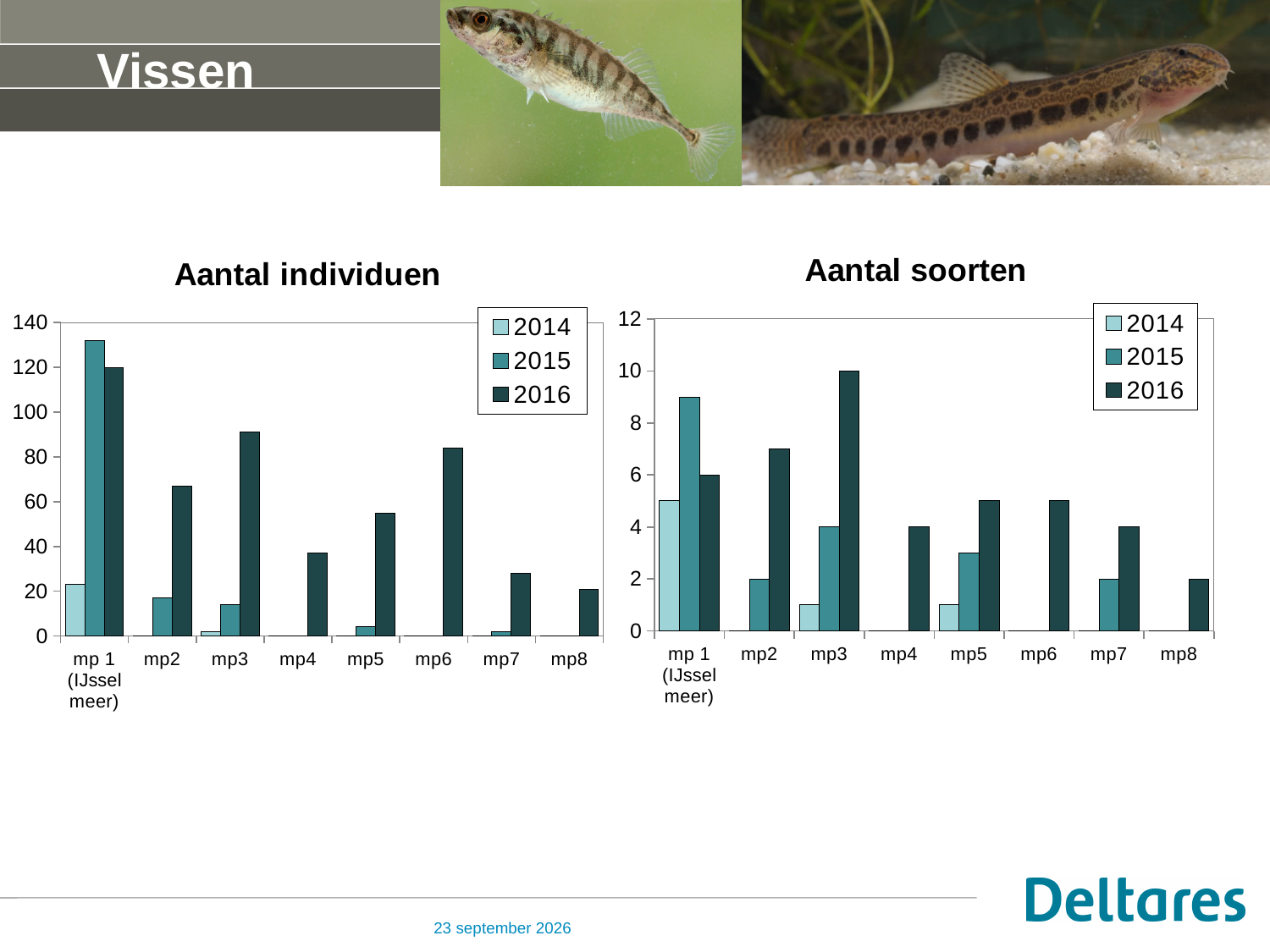
How many categories are shown on the x axis of the 'Aantal individuen' chart? 8 How many series does the legend of the 'Aantal soorten' chart list? 3 In the 'Aantal individuen' chart, is the 2015 value for mp 1 (IJssel meer) greater or less than 120? greater What kind of chart is the 'Aantal individuen' chart? bar chart In the 'Aantal soorten' chart, what is the 2016 value for mp4? 4 In the 'Aantal individuen' chart, is the 2016 value for mp4 greater or less than 40? less In the 'Aantal soorten' chart, for mp 1 (IJssel meer), which is larger: the 2015 value or the 2016 value? 2015 In the 'Aantal individuen' chart, which category has the highest 2016 bar? mp 1 (IJssel meer) In the 'Aantal soorten' chart, what is the 2016 value for mp3? 10 What are the legend entries of the 'Aantal individuen' chart? 2014, 2015, 2016 In the 'Aantal soorten' chart, what is the 2015 value for mp7? 2 In the 'Aantal soorten' chart, which category has the highest 2016 bar? mp3